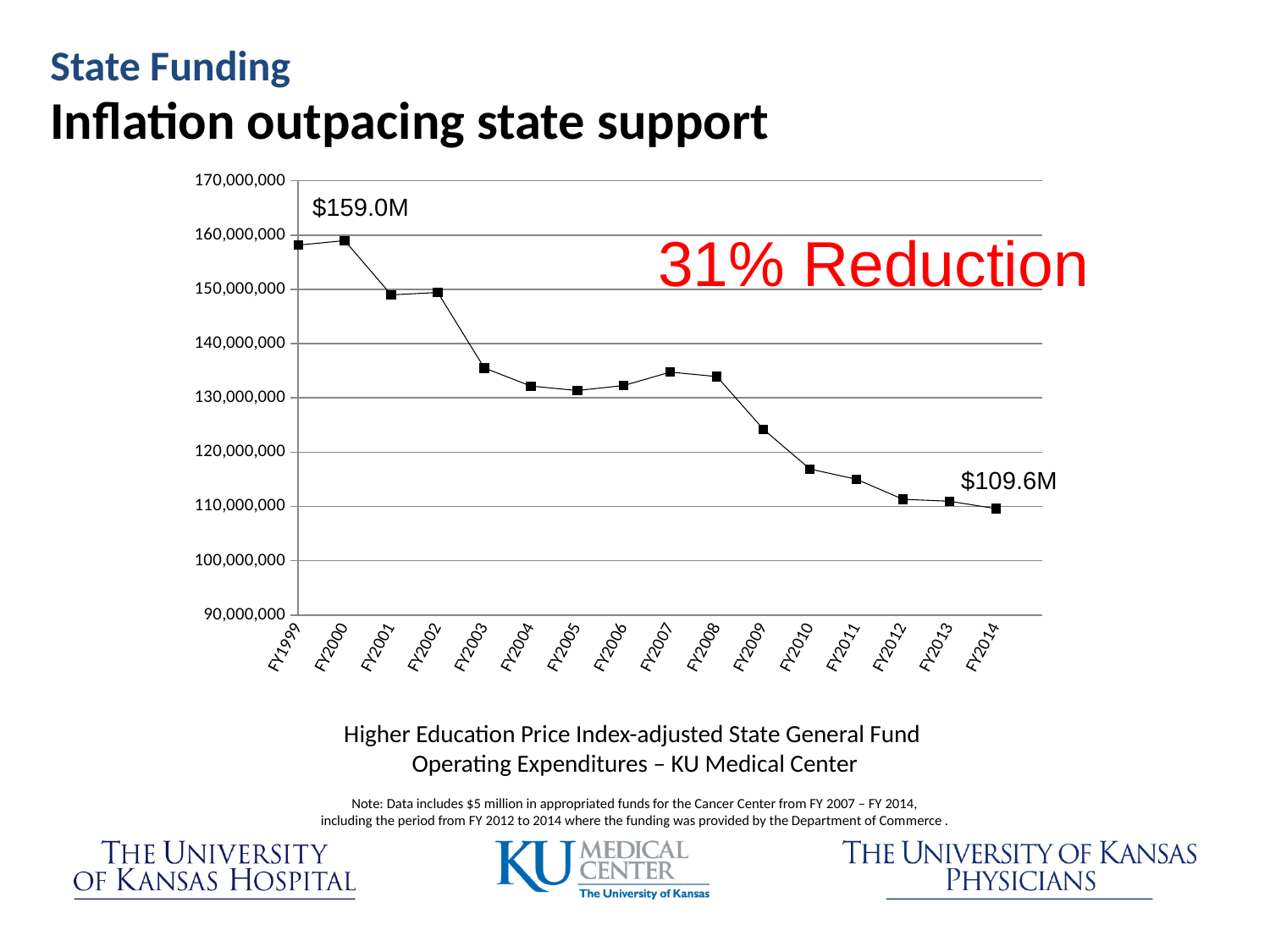
Is the value for FY2003 greater or less than 130,000,000? greater Which is larger, the value for FY2003 or the value for FY2009? FY2003 What is the highest value labeled on the chart? $159.0M Which fiscal year has the lowest value on the chart? FY2014 Which is larger, the value for FY2007 or the value for FY2005? FY2007 What percentage reduction is annotated in red on the chart? 31% Reduction Is the value for FY2009 greater or less than 120,000,000? greater Is the value for FY2010 greater or less than 120,000,000? less How many fiscal years are plotted on the x axis? 16 What value is labeled at the end of the line, at FY2014? $109.6M Overall, do the values rise or fall from FY1999 to FY2014? fall What kind of chart is shown on the slide? line chart